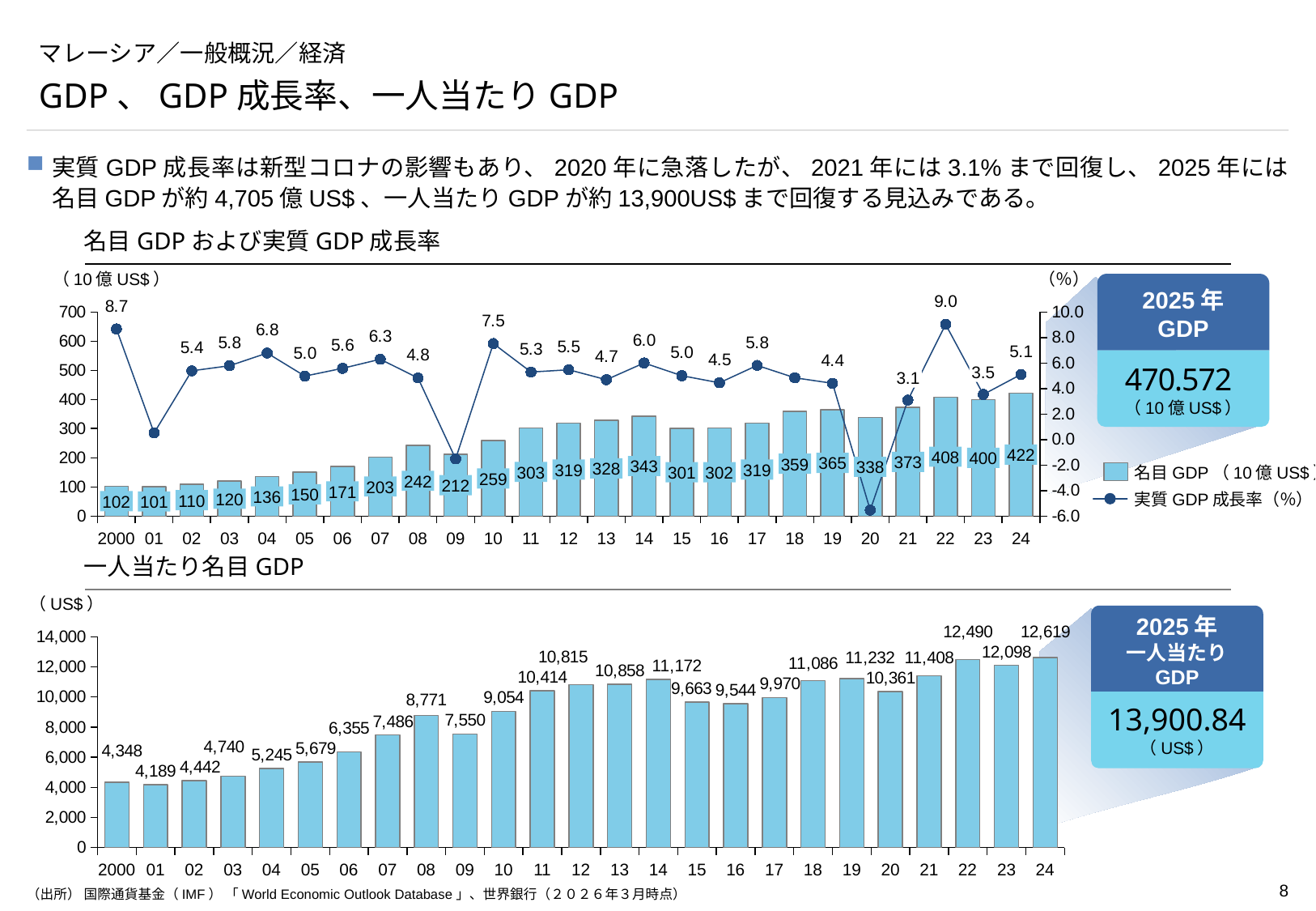
In the top chart (名目GDPおよび実質GDP成長率), what is the nominal GDP value for 2024? 422 In the bottom chart (一人当たり名目GDP), what is the difference between the 2024 value and the 2023 value? 521 In the bottom chart (一人当たり名目GDP), which year has the highest value? 2024 How many series does the legend of the top chart (名目GDPおよび実質GDP成長率) list? 2 In the top chart (名目GDPおよび実質GDP成長率), which year has the larger nominal GDP, 2022 or 2023? 2022 In the top chart (名目GDPおよび実質GDP成長率), what is the real GDP growth rate for 2022? 9.0 In the bottom chart (一人当たり名目GDP), do the values rise or fall from 2000 to 2008? rise In the bottom chart (一人当たり名目GDP), which year has the lowest value? 2001 In the top chart (名目GDPおよび実質GDP成長率), is the real GDP growth rate for 2020 greater or less than -4.0? less What kind of chart is the bottom chart (一人当たり名目GDP)? bar chart How many bars are plotted in the bottom chart (一人当たり名目GDP)? 25 In the top chart (名目GDPおよび実質GDP成長率), what is the difference between nominal GDP in 2024 and in 2020? 84